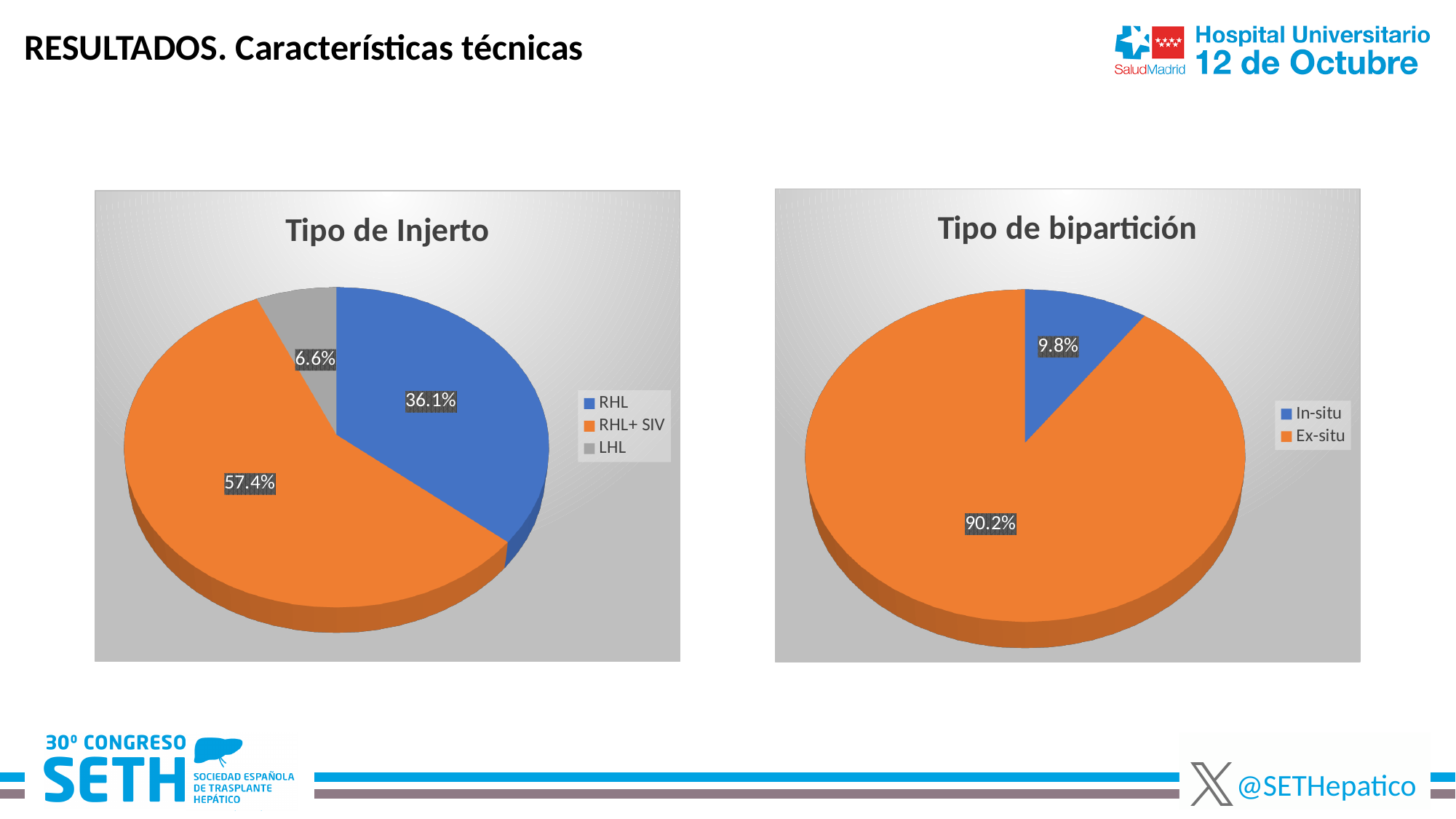
In the 'Tipo de Injerto' chart, what share does RHL+ SIV have? 57.4% In the 'Tipo de bipartición' chart, what is the difference between Ex-situ and In-situ? 80.4% In the 'Tipo de Injerto' chart, how many categories are shown? 3 What type of chart is the 'Tipo de bipartición' chart? Pie chart In the 'Tipo de Injerto' chart, what is the difference between RHL+ SIV and RHL? 21.3% In the 'Tipo de Injerto' chart, what is the value for LHL? 6.6% In the 'Tipo de bipartición' chart, what is the value for In-situ? 9.8% In the 'Tipo de bipartición' chart, which is larger, In-situ or Ex-situ? Ex-situ In the 'Tipo de bipartición' chart, what share does Ex-situ have? 90.2% In the 'Tipo de Injerto' chart, what is the value for RHL? 36.1% In the 'Tipo de Injerto' chart, which category has the smallest slice? LHL In the 'Tipo de Injerto' chart, which category has the largest slice? RHL+ SIV